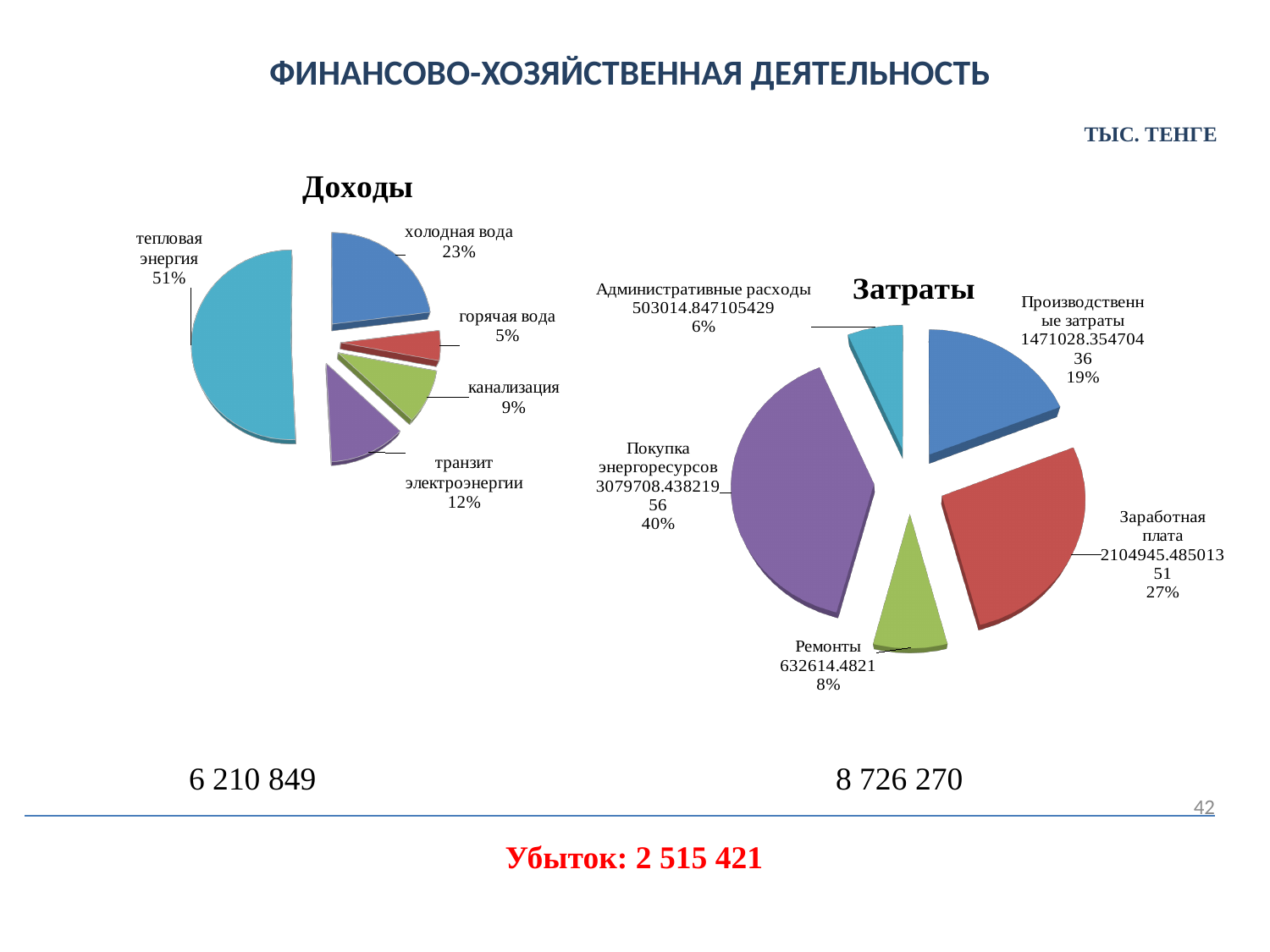
On the Затраты chart, which category has the largest share? Покупка энергоресурсов On the Доходы chart, what share does тепловая энергия have? 51% On the Затраты chart, what is the value for Ремонты? 632614.4821 What type of chart is the Затраты chart? pie chart On the Доходы chart, what share does холодная вода have? 23% On the Затраты chart, what is the value for Административные расходы? 503014.847105429 On the Затраты chart, what share does Покупка энергоресурсов have? 40% On the Доходы chart, which category has the largest share? тепловая энергия On the Доходы chart, how many categories are shown? 5 On the Доходы chart, what is the difference in percentage points between канализация and горячая вода? 4 On the Доходы chart, which category has the smallest share? горячая вода On the Затраты chart, which is larger: Заработная плата or Производственные затраты? Заработная плата